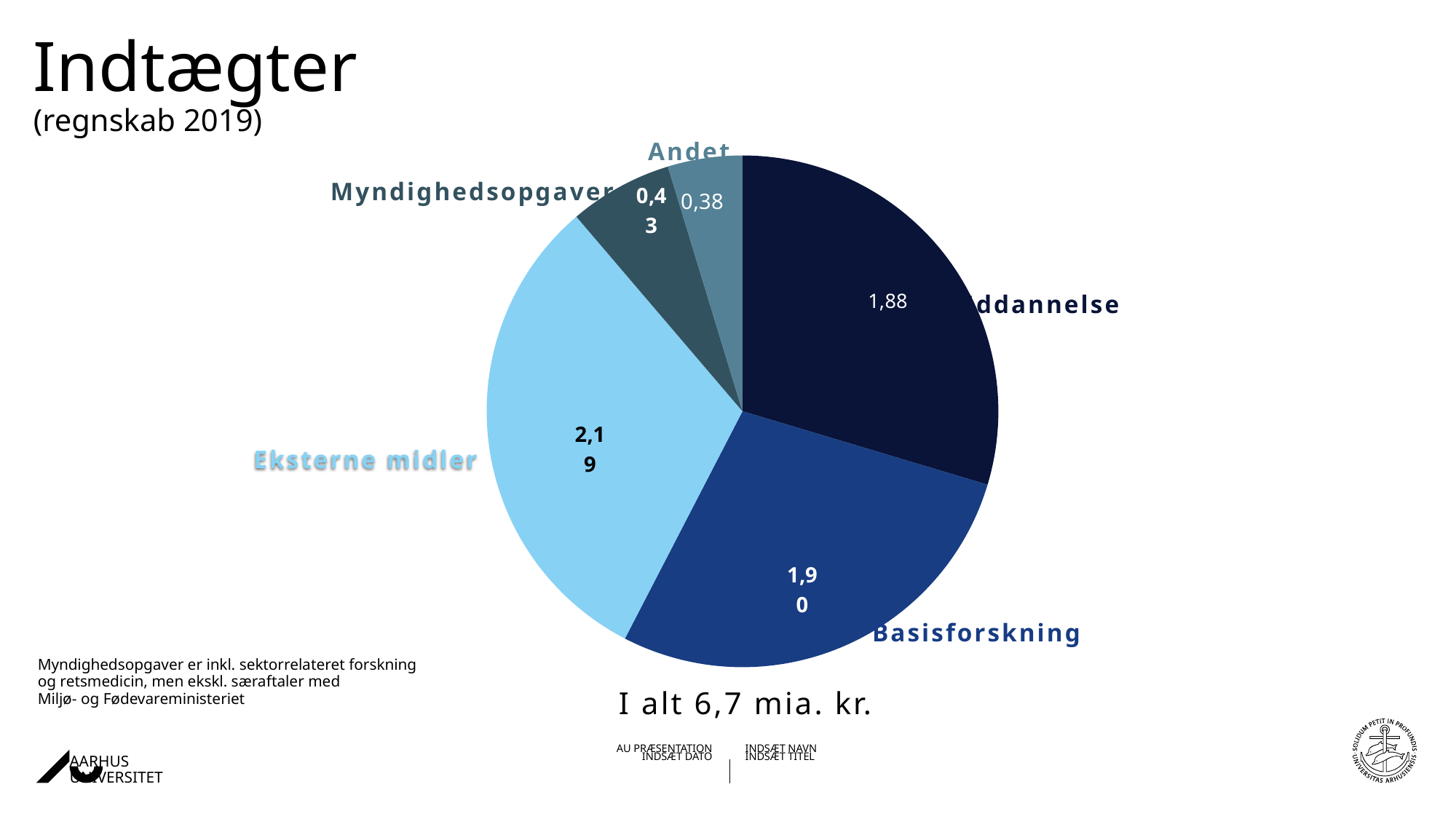
What is the value shown for Uddannelse? 1,88 Which category has the smallest slice of the pie? Andet What is the value shown for Basisforskning? 1,90 What is the value shown for Eksterne midler? 2,19 What kind of chart is shown on the slide? Pie chart What is the difference between the values for Eksterne midler and Basisforskning? 0,29 What total amount is stated below the pie chart? 6,7 mia. kr. How many slices does the pie chart have? 5 What is the value shown for Myndighedsopgaver? 0,43 Which is larger, the value for Eksterne midler or the value for Myndighedsopgaver? Eksterne midler Which category has the largest slice of the pie? Eksterne midler What is the value shown for Andet? 0,38